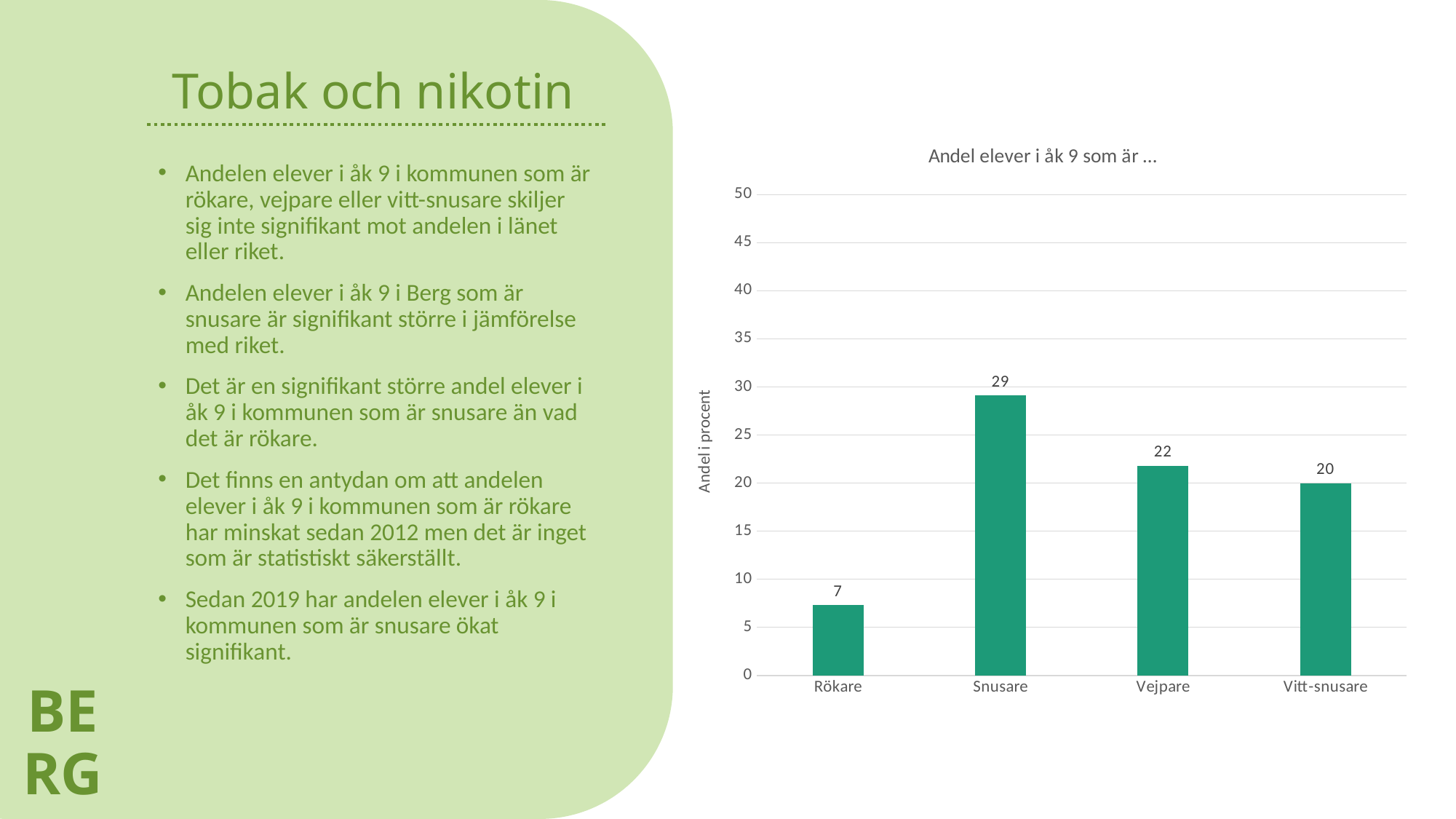
What is the difference between the values for Snusare and Rökare? 22 What is the title of the chart? Andel elever i åk 9 som är … Which category has the highest value? Snusare Which is larger, the value for Vejpare or the value for Vitt-snusare? Vejpare What is the value for Vejpare? 22 How many categories are shown on the x axis? 4 Which category has the lowest value? Rökare What is the value for Rökare? 7 What is the value for Vitt-snusare? 20 What kind of chart is shown on the slide? bar chart What is the value for Snusare? 29 Is the value for Snusare greater or less than 25? greater